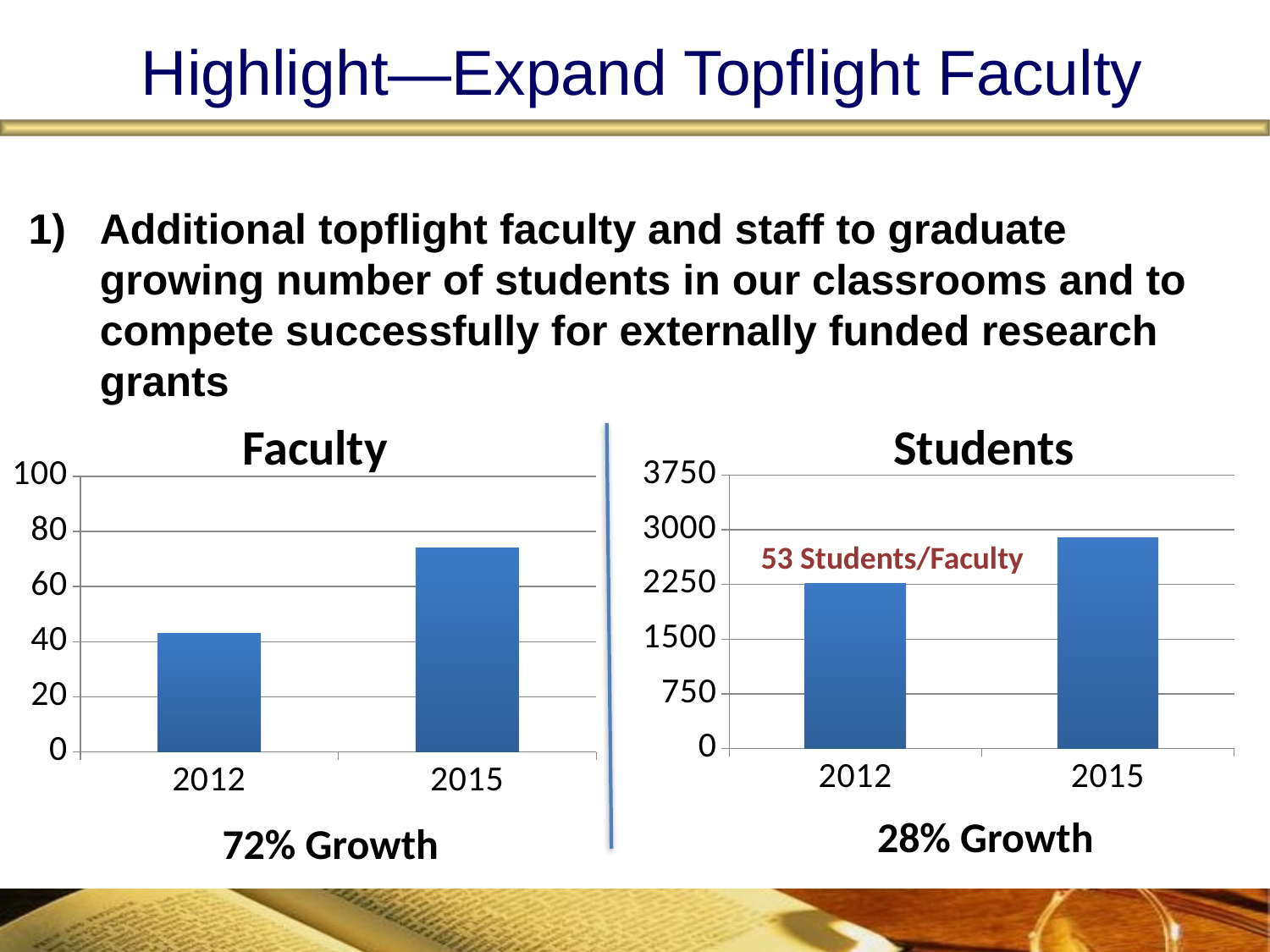
In the Students chart, is the value for 2015 greater or less than 3000? less In the Students chart, is the value for 2015 greater or less than 2250? greater In the Students chart, which year has the lower value? 2012 In the Faculty chart, which year has the higher value? 2015 What growth percentage is printed below the Faculty chart? 72% Growth How many categories are shown on the x axis of the Students chart? 2 In the Students chart, do the values rise or fall from 2012 to 2015? rise What annotation is printed above the 2012 bar in the Students chart? 53 Students/Faculty In the Faculty chart, is the value for 2015 greater or less than 80? less What type of chart is the Faculty chart? bar chart